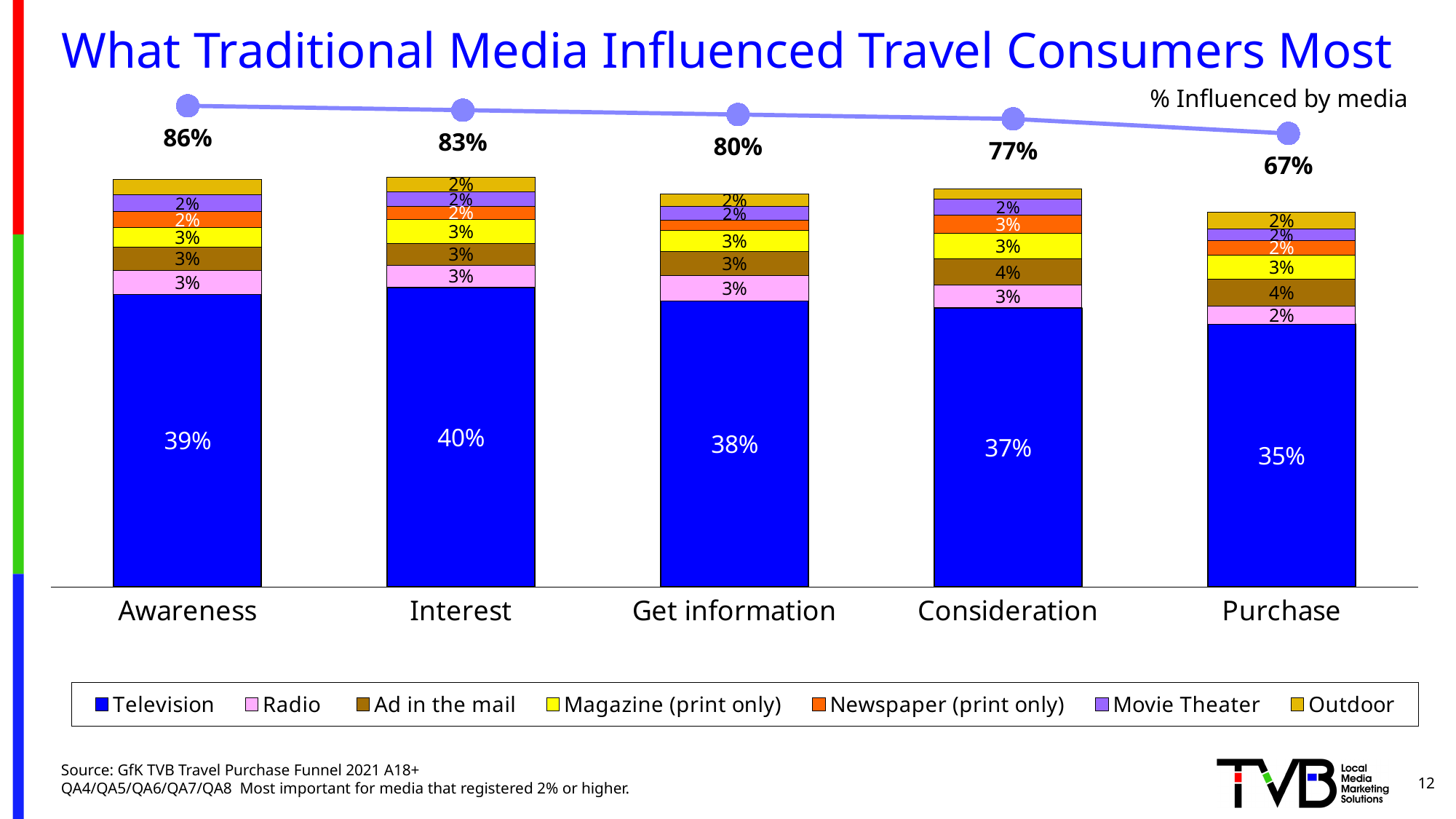
What is the difference between the Television values for Awareness and Purchase? 4 percentage points What is the Ad in the mail value for the Purchase stage? 4% How many series does the legend list? 7 How many stages are shown on the x axis? 5 What is the difference between the % Influenced by media values for Awareness and Purchase? 19 percentage points Does the % Influenced by media line rise or fall from Awareness to Purchase? Falls Which stage has the lowest % Influenced by media value? Purchase Which has the larger Television value, Get information or Consideration? Get information What is the % Influenced by media value for Purchase? 67% What is the Television value for the Interest stage? 40% Which stage has the highest Television value? Interest What is the Radio value for the Purchase stage? 2%